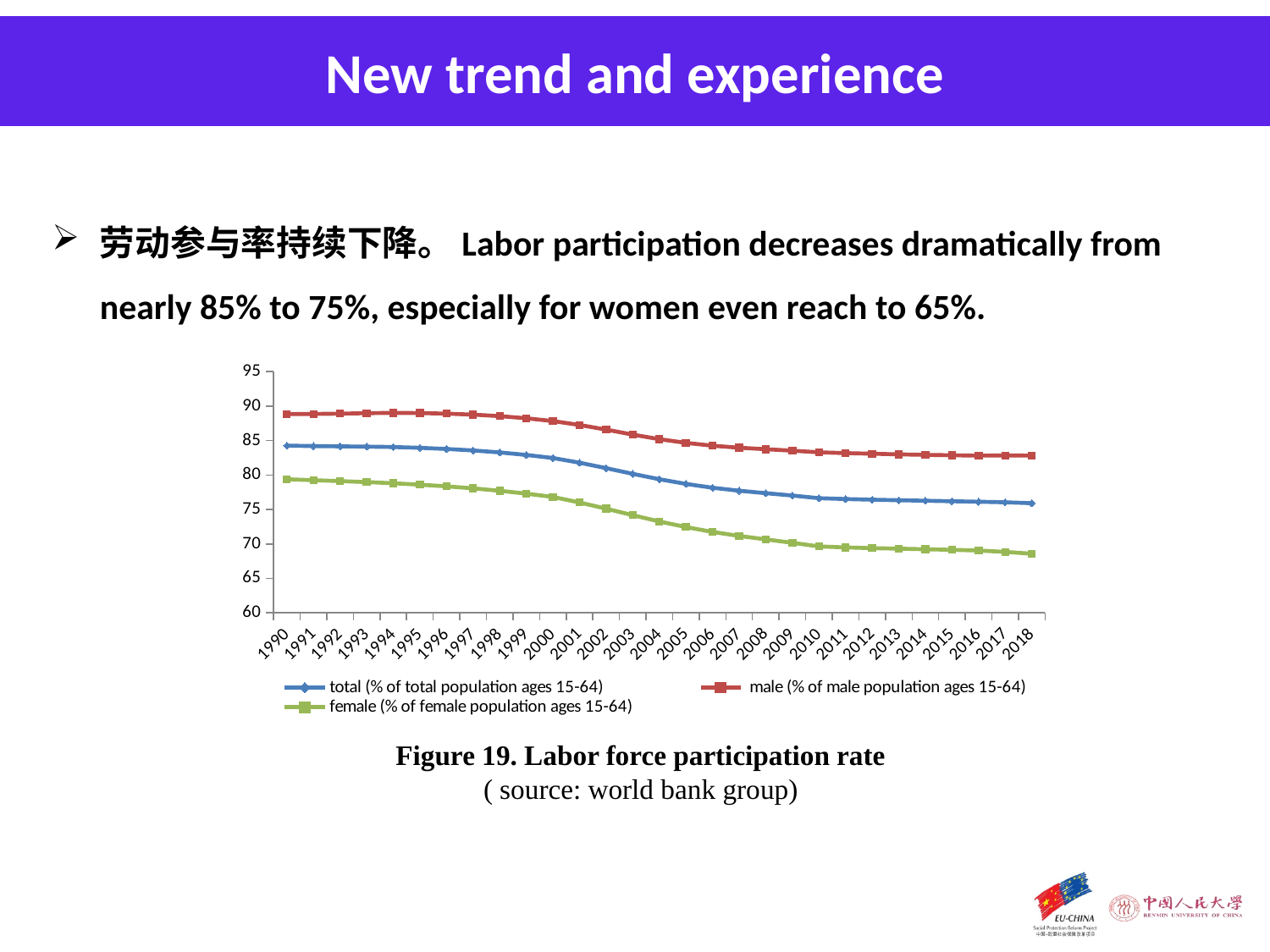
Is the value for the male series in 1990 greater or less than 85? greater Is the value for the female series in 2005 greater or less than 70? greater In 2018, which is larger: the male series or the female series? male Is the value for the male series in 2018 greater or less than 80? greater How many years are plotted along the x axis of the chart? 29 What kind of chart is shown in Figure 19? line chart How many series does the legend of the chart list? 3 What is the title of the figure shown on the slide? Figure 19. Labor force participation rate Do the values of the total series rise or fall from 1990 to 2018? fall Which series has the lowest values throughout the chart? female (% of female population ages 15-64) Which series has the highest values throughout the chart? male (% of male population ages 15-64)